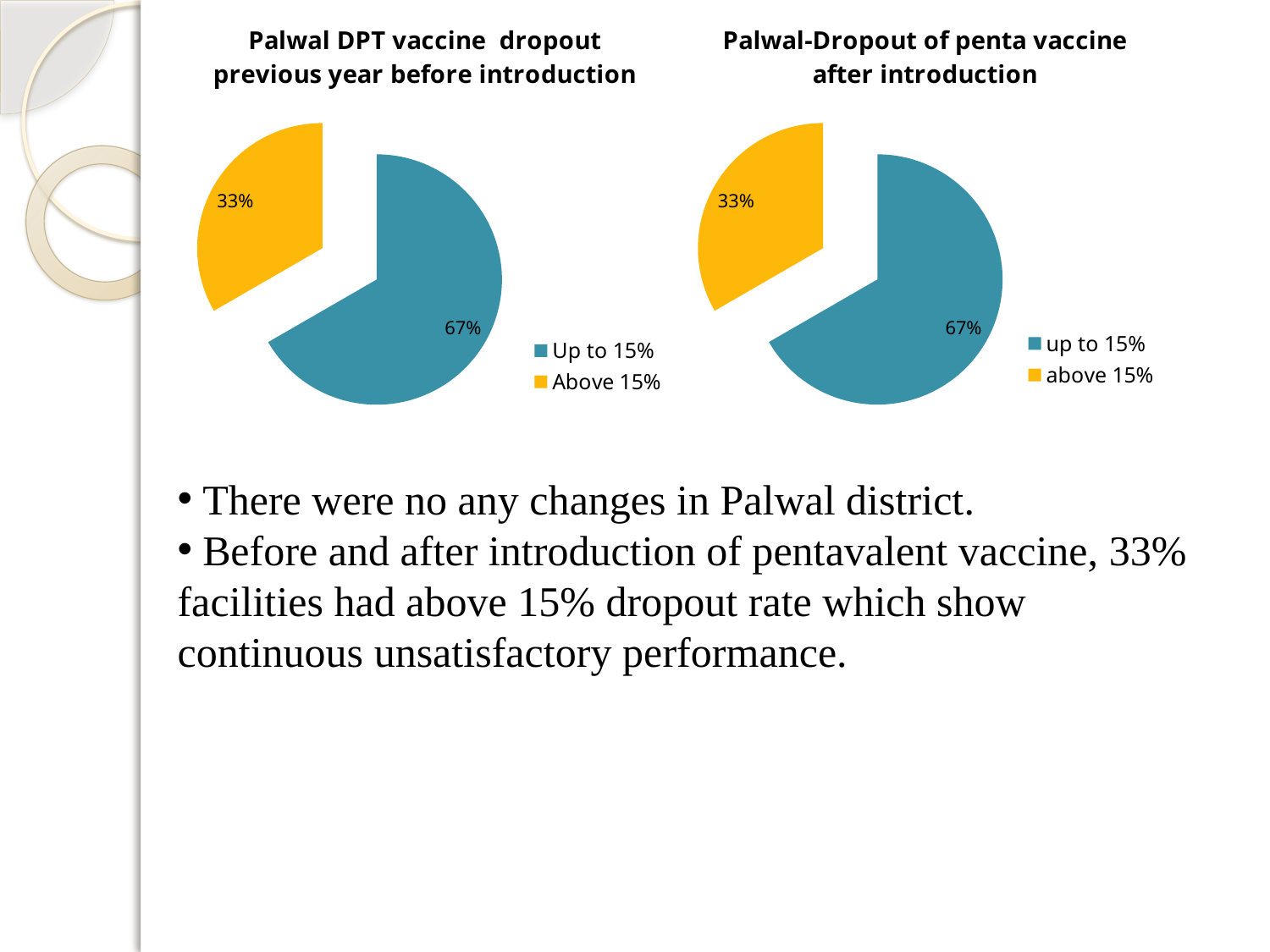
In the right chart, what colour is the 'above 15%' slice? Yellow In the chart titled 'Palwal DPT vaccine dropout previous year before introduction', what share of the pie is 'Above 15%'? 33% How many entries does the legend of the left chart list? 2 In the chart titled 'Palwal-Dropout of penta vaccine after introduction', what share of the pie is 'above 15%'? 33% In the right chart, which category has the smallest slice? above 15% How many slices does the chart titled 'Palwal-Dropout of penta vaccine after introduction' have? 2 In the left chart, which category has the largest slice? Up to 15% In the chart titled 'Palwal DPT vaccine dropout previous year before introduction', what share of the pie is 'Up to 15%'? 67% In the left chart, what is the difference between the 'Up to 15%' and 'Above 15%' shares? 34% What kind of chart is the chart titled 'Palwal DPT vaccine dropout previous year before introduction'? Pie chart In the right chart, which is larger, the 'up to 15%' slice or the 'above 15%' slice? up to 15%